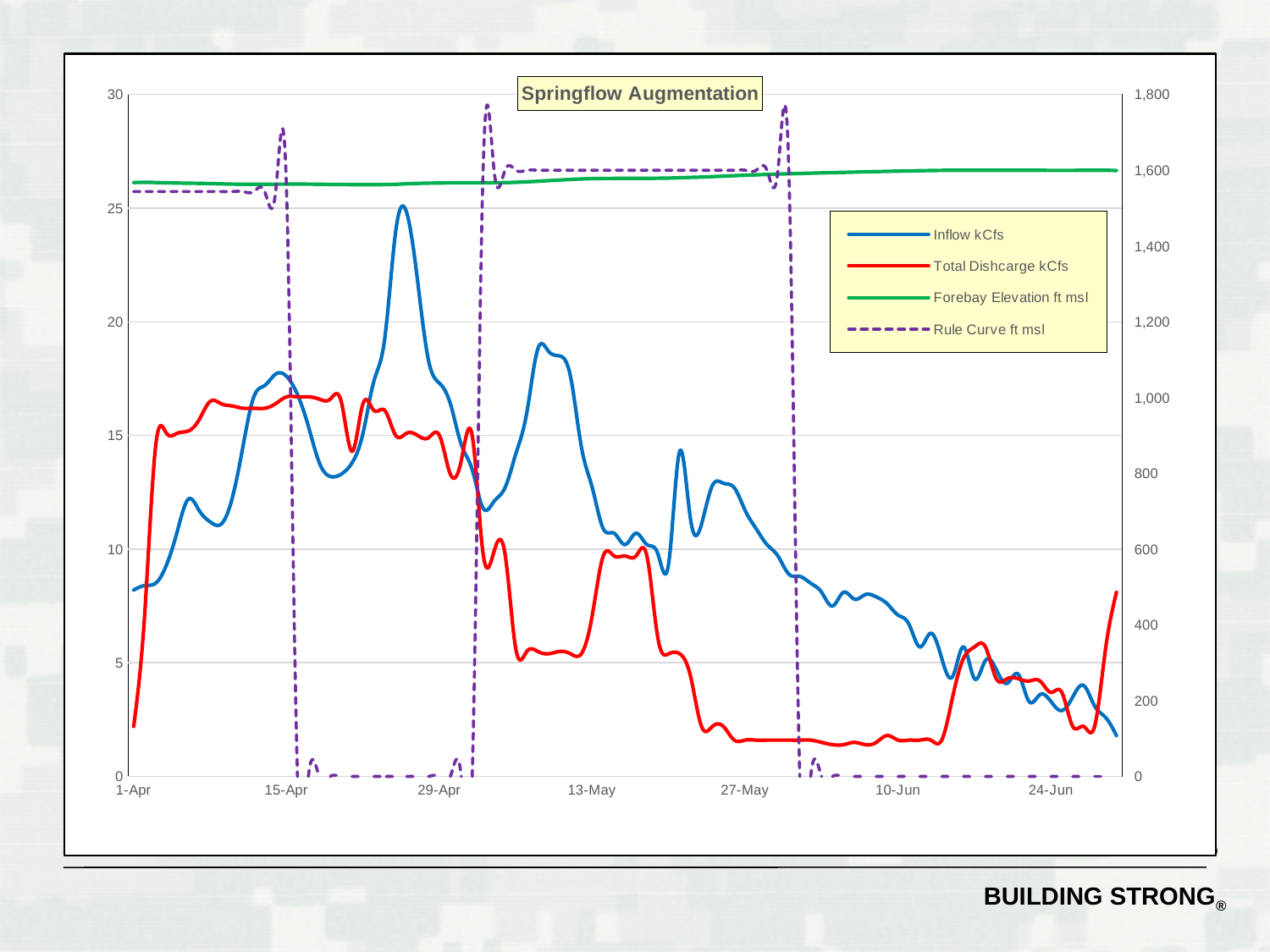
Is the value of Rule Curve ft msl on 29-Apr greater or less than 200? less Is the value of Total Dishcarge kCfs on 1-Apr greater or less than 5? less Is the value of Inflow kCfs on 1-Apr greater or less than 10? less Which is larger on 10-Jun, Inflow kCfs or Total Dishcarge kCfs? Inflow kCfs What kind of chart is shown on the slide? Line chart What is the title of the chart? Springflow Augmentation Which is larger on 27-Apr, Inflow kCfs or Total Dishcarge kCfs? Inflow kCfs Does Inflow kCfs generally rise or fall from 27-May to the end of June? fall How many series does the legend list? 4 Which series is drawn with a dashed line? Rule Curve ft msl